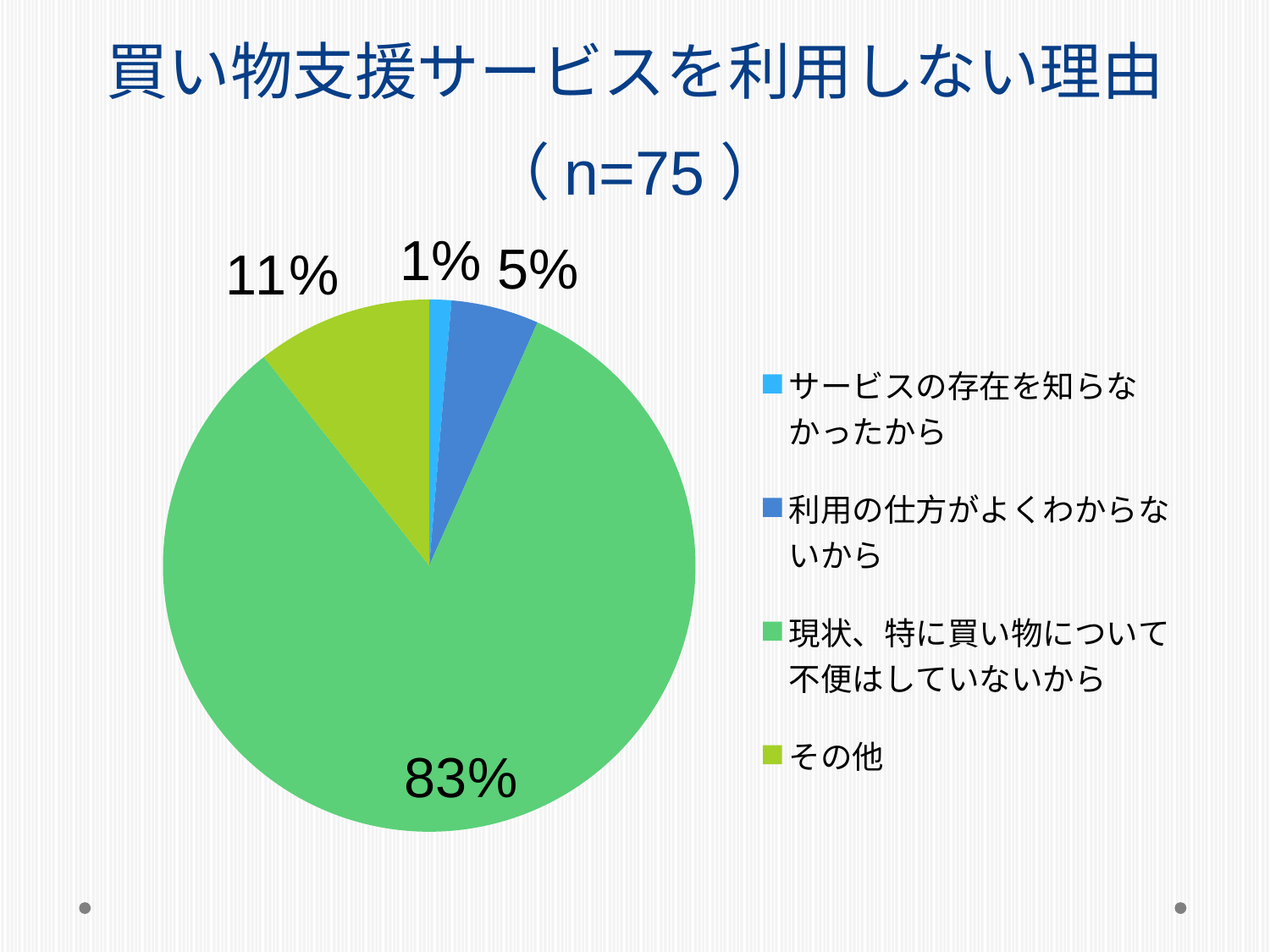
Which category has the largest slice of the pie? 現状、特に買い物について不便はしていないから What colour is the slice for その他? yellow-green What kind of chart is shown on the slide? pie chart What is the difference in percentage points between その他 and 利用の仕方がよくわからないから? 6 How many categories does the pie chart have? 4 Which category has the smallest slice of the pie? サービスの存在を知らなかったから What share of the pie is labelled for その他? 11% What share of the pie is labelled for サービスの存在を知らなかったから? 1% What is the sample size (n) shown in the chart title? 75 What share of the pie is labelled for 現状、特に買い物について不便はしていないから? 83% Which is larger, the slice for その他 or the slice for 利用の仕方がよくわからないから? その他